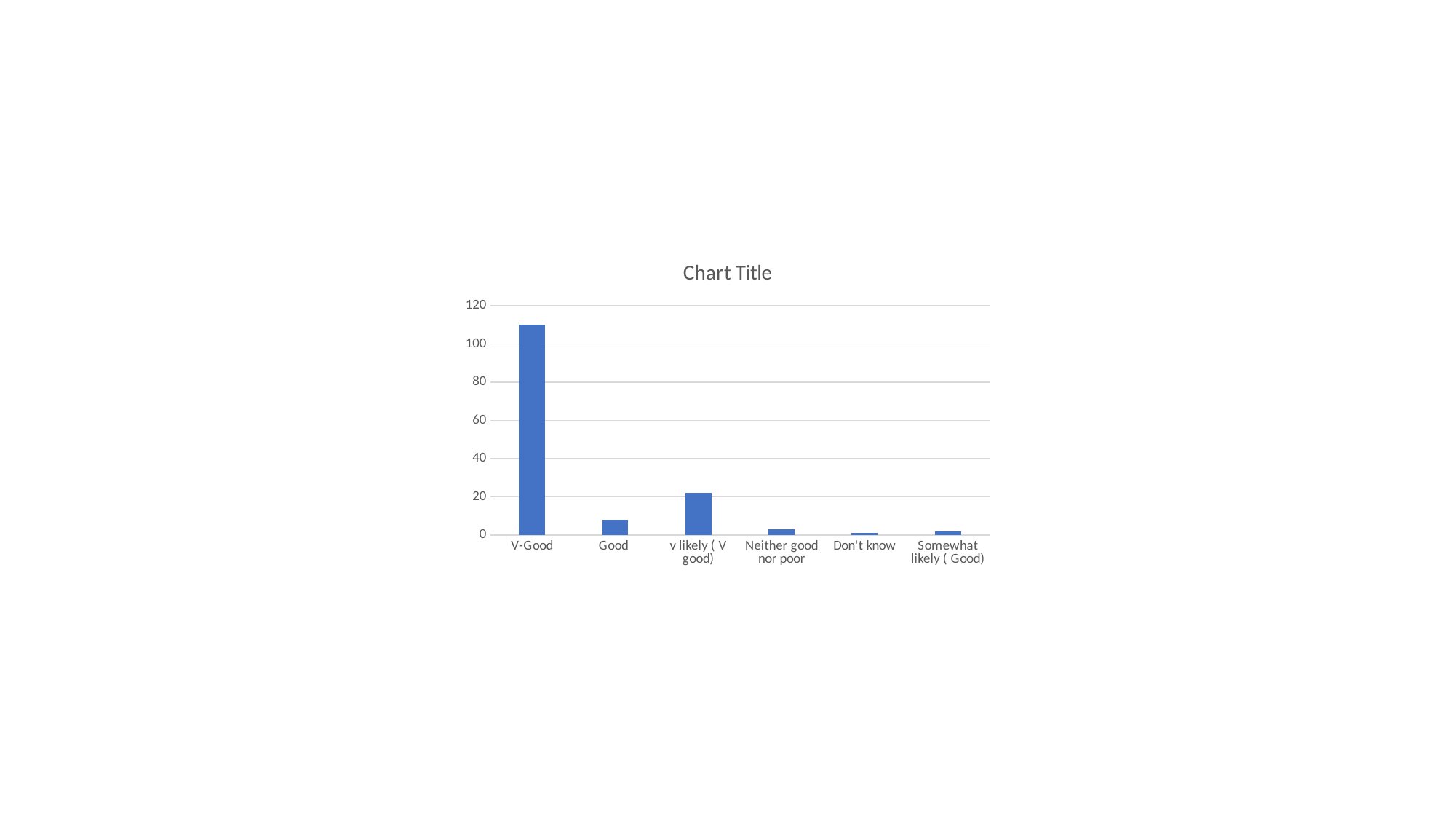
Which category has the highest bar in the chart? V-Good Is the value for V-Good greater or less than 100? greater Is the value for V-Good greater or less than 120? less Which is larger, the value for v likely ( V good) or the value for Good? v likely ( V good) Is the value for Neither good nor poor greater or less than 20? less Which is larger, the value for V-Good or the value for v likely ( V good)? V-Good What kind of chart is shown on the slide? bar chart What is the title of the chart? Chart Title How many categories are shown on the x axis of the chart? 6